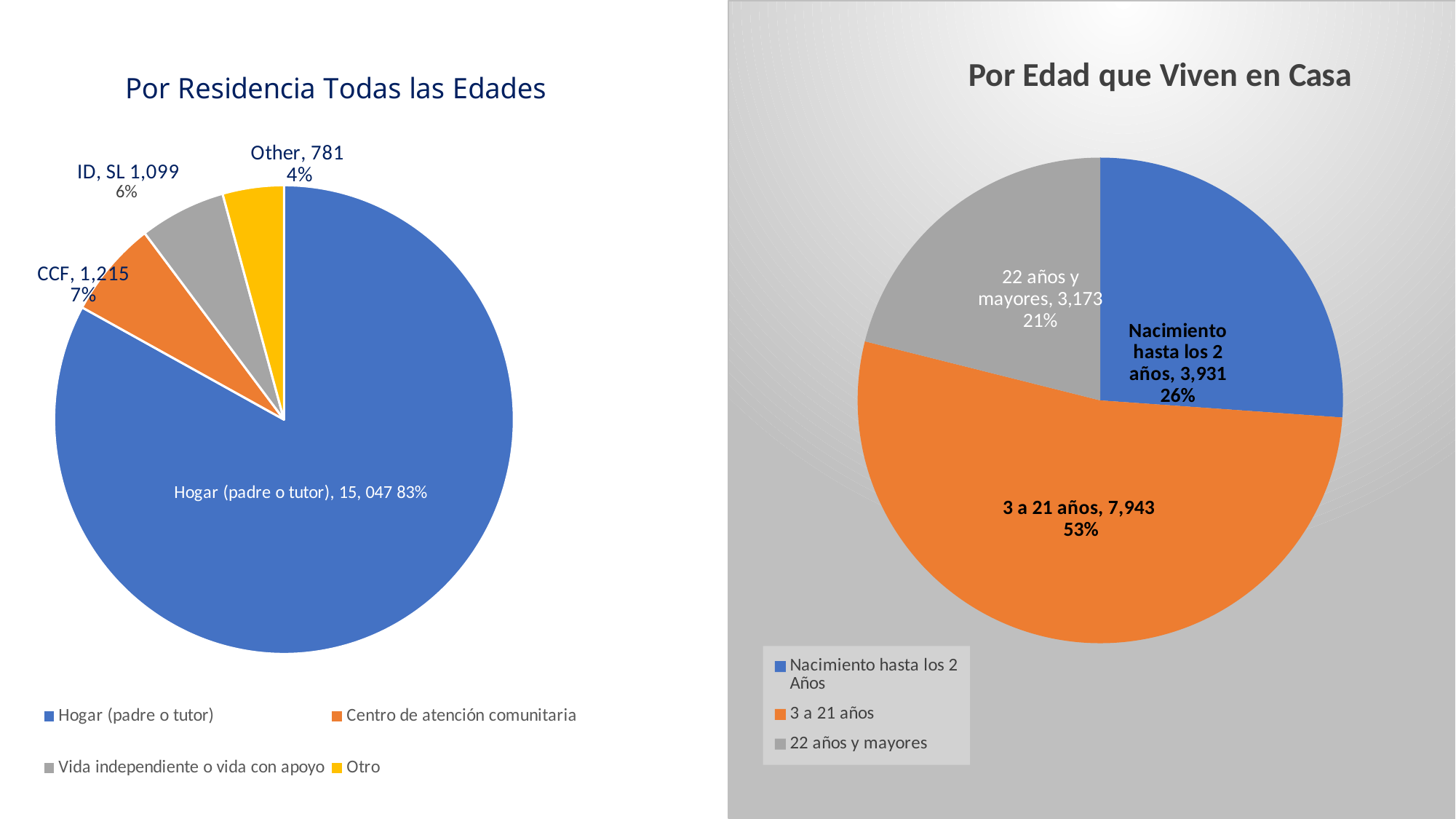
In the 'Por Residencia Todas las Edades' chart, what percentage share does the CCF slice have? 7% In the 'Por Residencia Todas las Edades' chart, how many slices does the pie have? 4 What type of chart is 'Por Edad que Viven en Casa'? Pie chart In the 'Por Edad que Viven en Casa' chart, what is the difference between the values for Nacimiento hasta los 2 años and 22 años y mayores? 758 In the 'Por Residencia Todas las Edades' chart, which category has the smallest slice? Other In the 'Por Edad que Viven en Casa' chart, what percentage share does the 22 años y mayores slice have? 21% In the 'Por Edad que Viven en Casa' chart, which category has the largest slice? 3 a 21 años In the 'Por Residencia Todas las Edades' chart, what value is shown for Hogar (padre o tutor)? 15, 047 In the 'Por Edad que Viven en Casa' chart, what value is shown for 3 a 21 años? 7,943 In the 'Por Edad que Viven en Casa' chart, how many entries does the legend list? 3 In the 'Por Residencia Todas las Edades' chart, what is the difference between the CCF value and the ID, SL value? 116 In the 'Por Residencia Todas las Edades' chart, what value is shown for the Other slice? 781